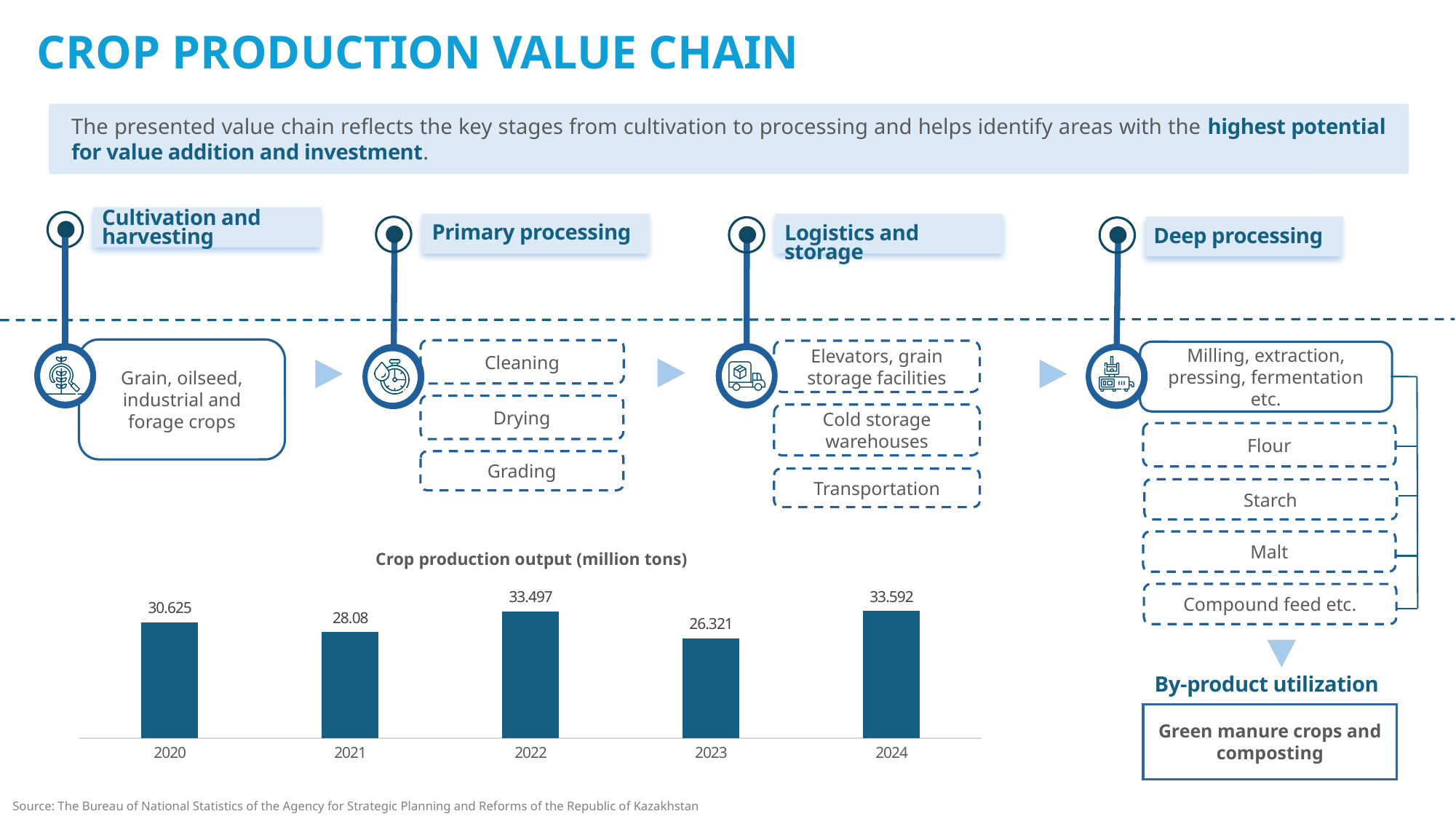
What kind of chart is used to show crop production output? Bar chart Which year has the highest crop production output? 2024 What is the difference in crop production output between 2022 and 2021? 5.417 What is the crop production output for 2020? 30.625 What is the crop production output for 2024? 33.592 What is the difference in crop production output between 2024 and 2023? 7.271 How many years are shown in the crop production output chart? 5 What is the title of the chart on the slide? Crop production output (million tons) Which year has the lowest crop production output? 2023 Did crop production output rise or fall from 2022 to 2023? Fall What is the crop production output for 2023? 26.321 Which year has the larger crop production output, 2020 or 2021? 2020